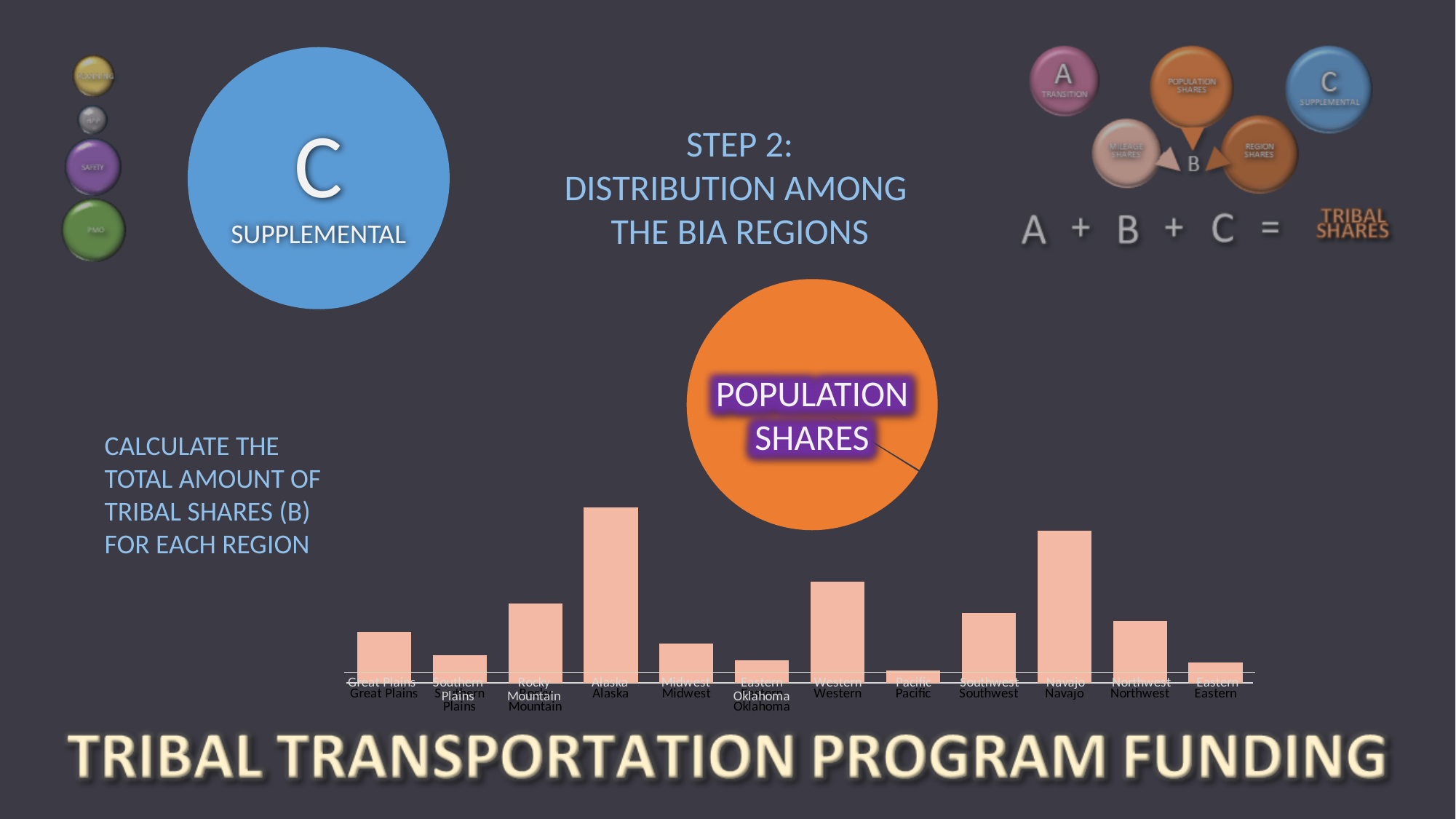
How many regions are shown as bars in the chart? 12 Which bar is taller, Navajo or Western? Navajo Which region has the shortest bar in the chart? Pacific Which bar is taller, Rocky Mountain or Great Plains? Rocky Mountain Which bar is taller, Southern Plains or Pacific? Southern Plains Which region's bar appears first on the left of the chart? Great Plains What colour are the bars in the chart? light salmon (peach) What kind of chart is shown at the bottom of the slide? bar chart Which region has the tallest bar in the chart? Alaska Which region has the second tallest bar in the chart? Navajo